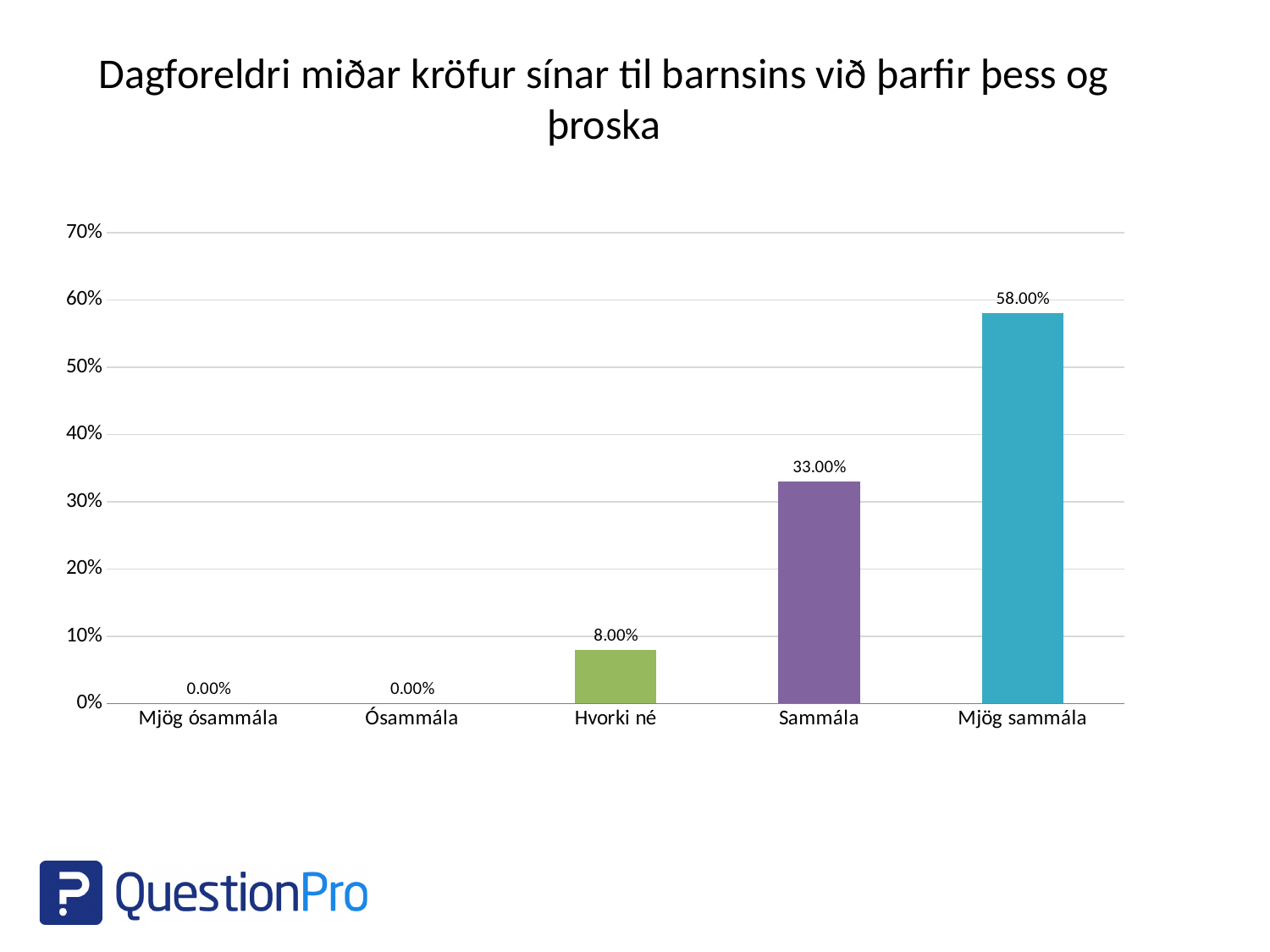
What is the difference between the values for Mjög sammála and Sammála? 25.00% What is the value for Sammála? 33.00% What is the value for Mjög sammála? 58.00% What is the value for Hvorki né? 8.00% What is the value for Ósammála? 0.00% Is the value for Mjög sammála greater or less than 50%? greater What is the difference between the values for Sammála and Hvorki né? 25.00% Which category has the highest value? Mjög sammála Do the values rise or fall from left to right along the x axis? rise Which is larger, the value for Sammála or the value for Hvorki né? Sammála How many categories are shown on the x axis? 5 What kind of chart is shown on the slide? bar chart